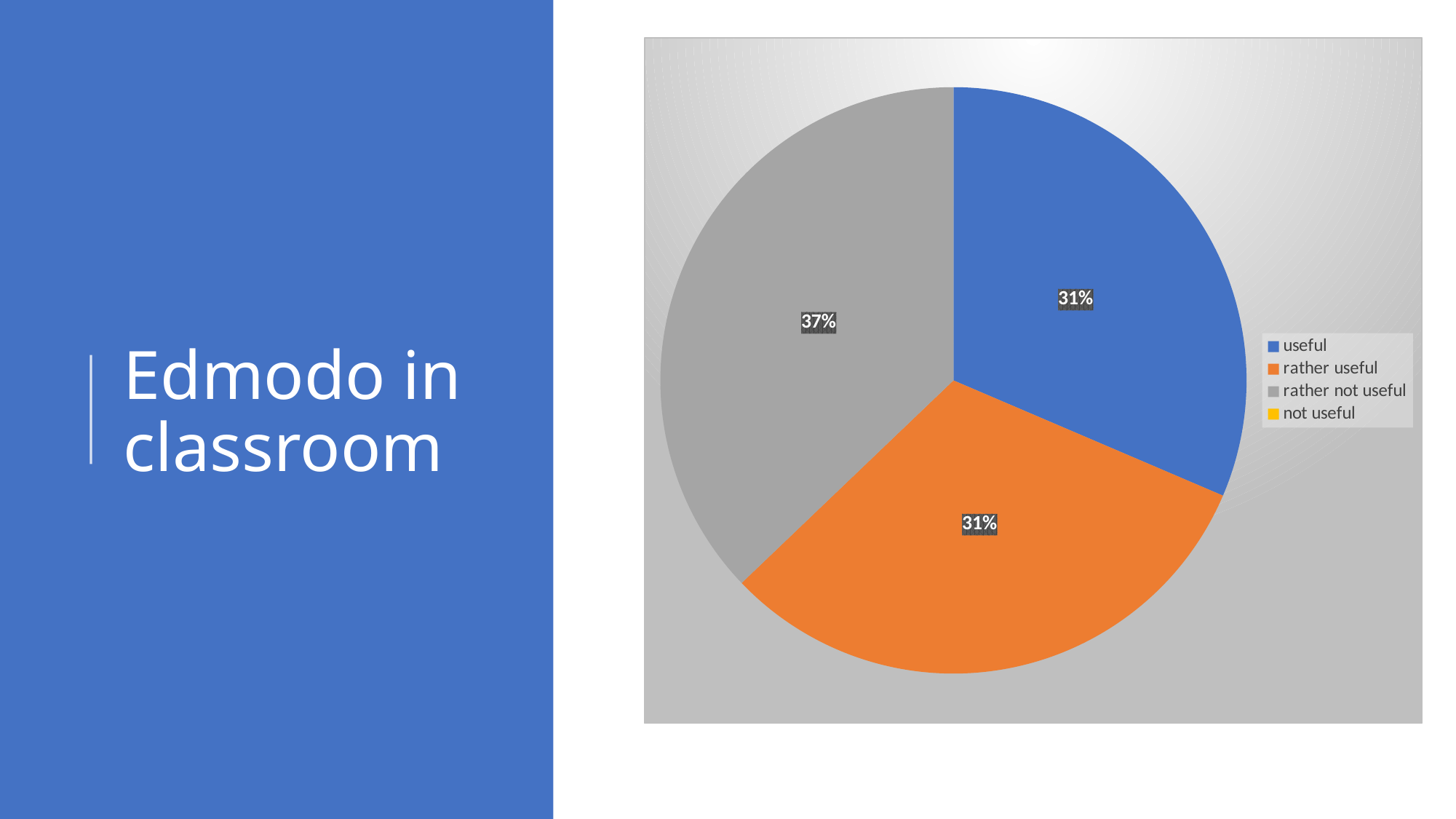
What share of the pie is labelled "rather not useful"? 37% How many entries does the legend list? 4 What colour is the "rather useful" slice? orange Which legend entry has no visible slice in the pie? not useful What kind of chart is shown on the slide? pie chart Which category has the largest slice of the pie? rather not useful What share of the pie is labelled "useful"? 31% What is the difference between the "rather not useful" share and the "useful" share? 6% What is the combined share of "useful" and "rather useful"? 62% What share of the pie is labelled "rather useful"? 31% Is the share for "rather not useful" larger than the share for "rather useful"? yes